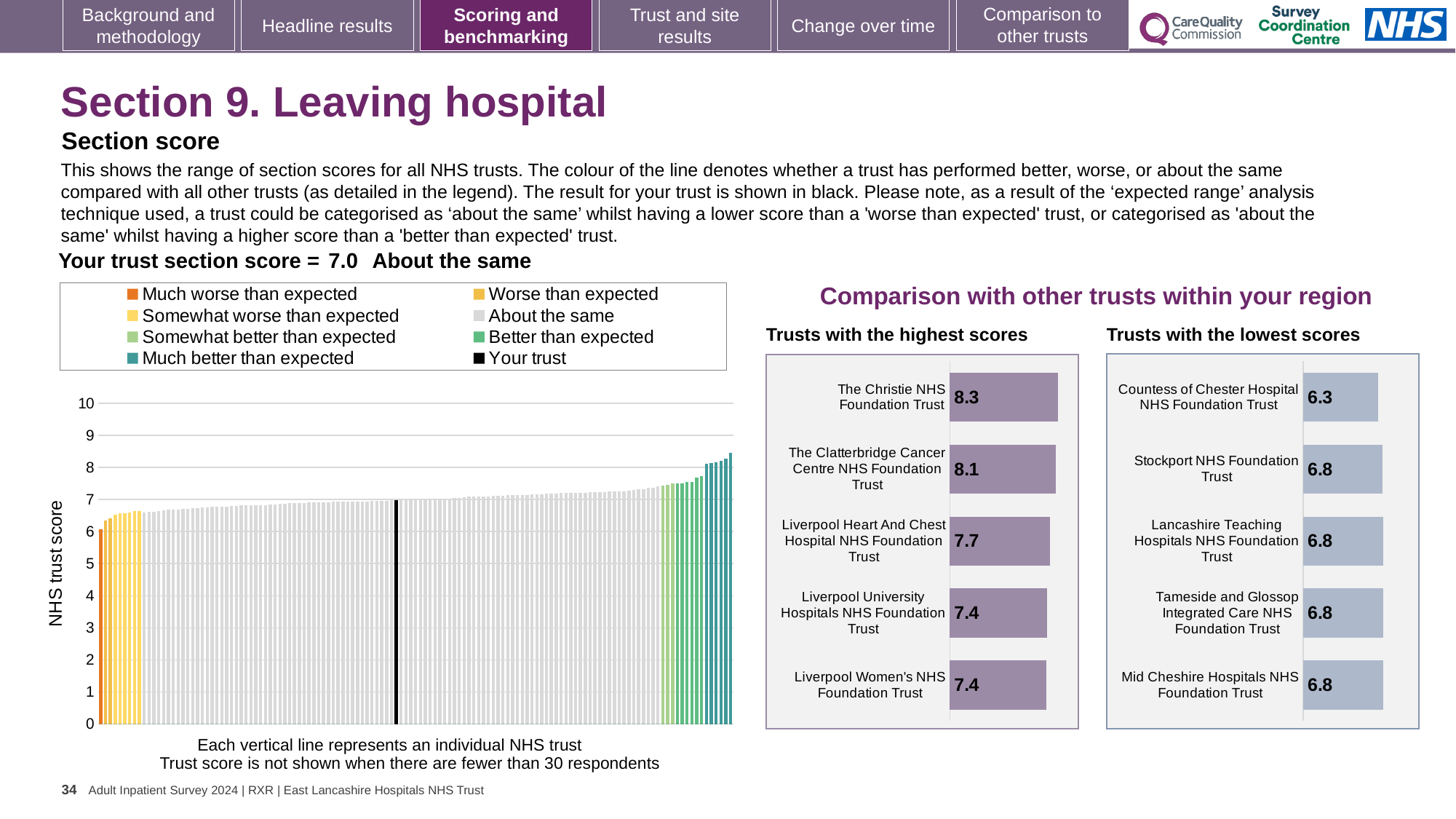
In the 'Trusts with the lowest scores' chart, which trust has the lowest score? Countess of Chester Hospital NHS Foundation Trust In the large 'NHS trust score' chart, is the value of the tallest bar on the far right greater or less than 8? greater Which has the larger score: Liverpool Heart And Chest Hospital NHS Foundation Trust in the highest scores chart, or Stockport NHS Foundation Trust in the lowest scores chart? Liverpool Heart And Chest Hospital NHS Foundation Trust In the 'Trusts with the lowest scores' chart, what is the score for Countess of Chester Hospital NHS Foundation Trust? 6.3 How many entries does the legend of the large 'NHS trust score' chart list? 8 In the 'Trusts with the highest scores' chart, what is the difference between the scores of The Christie NHS Foundation Trust and The Clatterbridge Cancer Centre NHS Foundation Trust? 0.2 In the 'Trusts with the highest scores' chart, which trust has the highest score? The Christie NHS Foundation Trust According to the slide, what is your trust's section score for Leaving hospital? 7.0 In the large 'NHS trust score' chart, do the bar values rise or fall from left to right? rise In the 'Trusts with the highest scores' chart, what is the score for The Christie NHS Foundation Trust? 8.3 What kind of chart is the large 'NHS trust score' chart on the left of the slide? bar chart How many trusts are shown in the 'Trusts with the highest scores' chart? 5